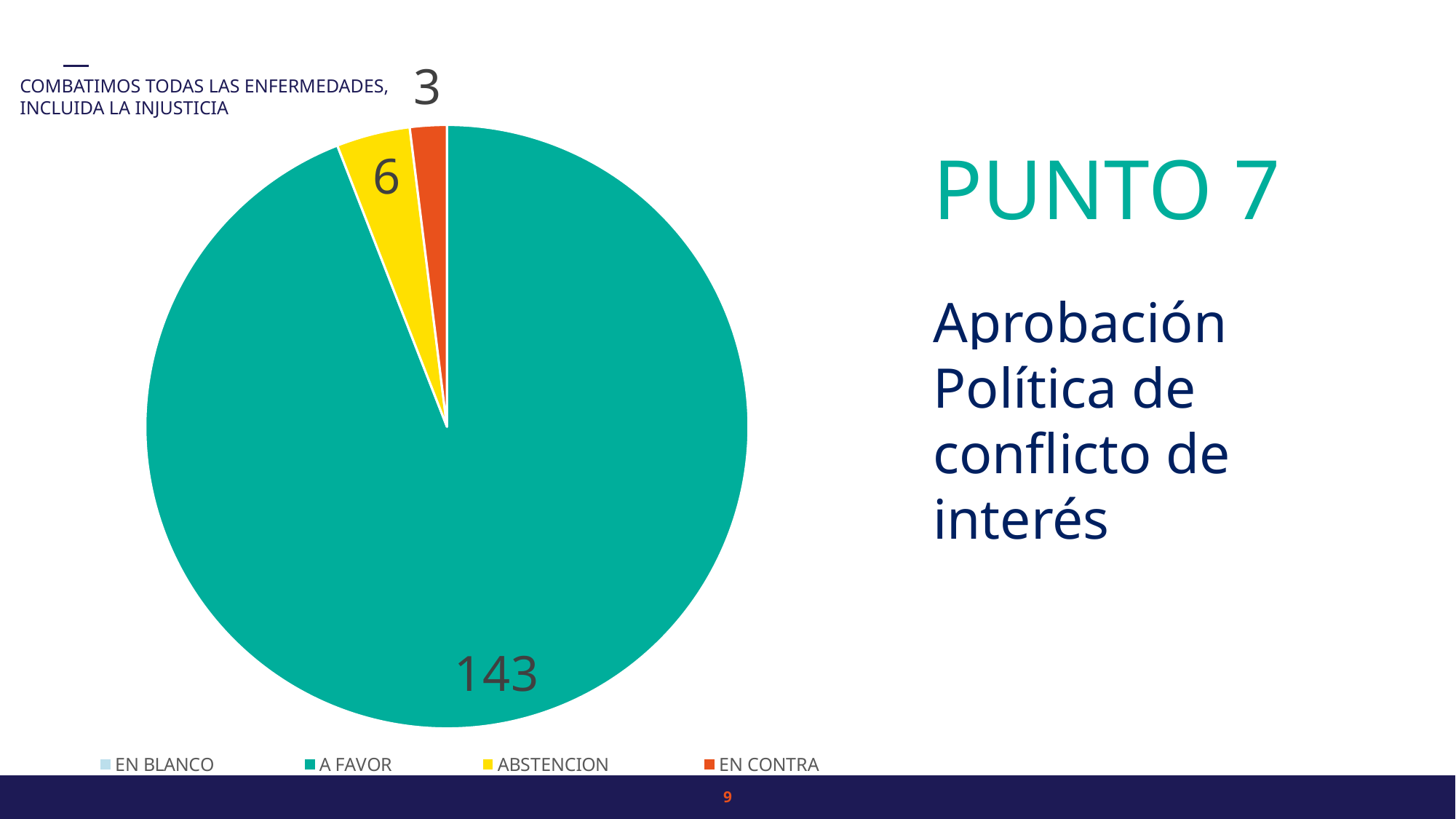
What is the difference between the values for A FAVOR and ABSTENCION? 137 What is the value for EN CONTRA in the pie chart? 3 Which category has the largest slice of the pie chart? A FAVOR What colour is the A FAVOR slice in the pie chart? Teal Which is larger, the value for ABSTENCION or the value for EN CONTRA? ABSTENCION What is the value for A FAVOR in the pie chart? 143 Which legend entry is shown in yellow? ABSTENCION What is the difference between the values for ABSTENCION and EN CONTRA? 3 What is the value for ABSTENCION in the pie chart? 6 How many categories does the legend of the pie chart list? 4 What kind of chart is shown on the slide? Pie chart Which category has the smallest visible slice of the pie chart? EN CONTRA